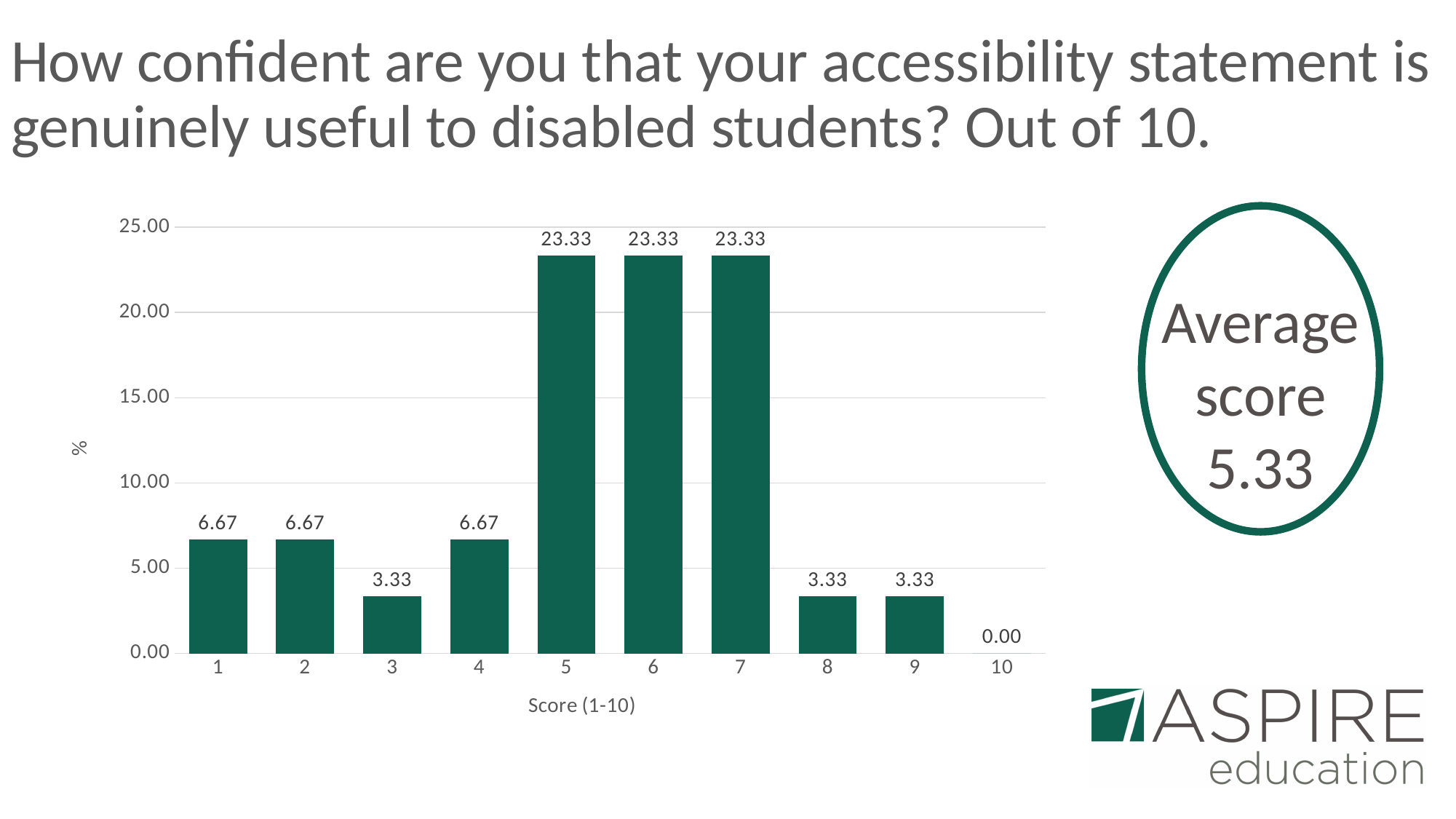
What kind of chart is shown on the slide? Bar chart What is the difference in percentage between score 7 and score 8? 20.00 Is the value for score 6 greater or less than 20.00? greater What percentage of respondents gave a score of 1? 6.67 What is the average score shown in the circle on the slide? 5.33 Which has a higher percentage, score 2 or score 3? Score 2 Which score has the lowest percentage of respondents? 10 How many score categories are shown on the x axis? 10 What percentage of respondents gave a score of 3? 3.33 What is the difference in percentage between score 4 and score 9? 3.34 What percentage of respondents gave a score of 10? 0.00 What percentage of respondents gave a score of 5? 23.33